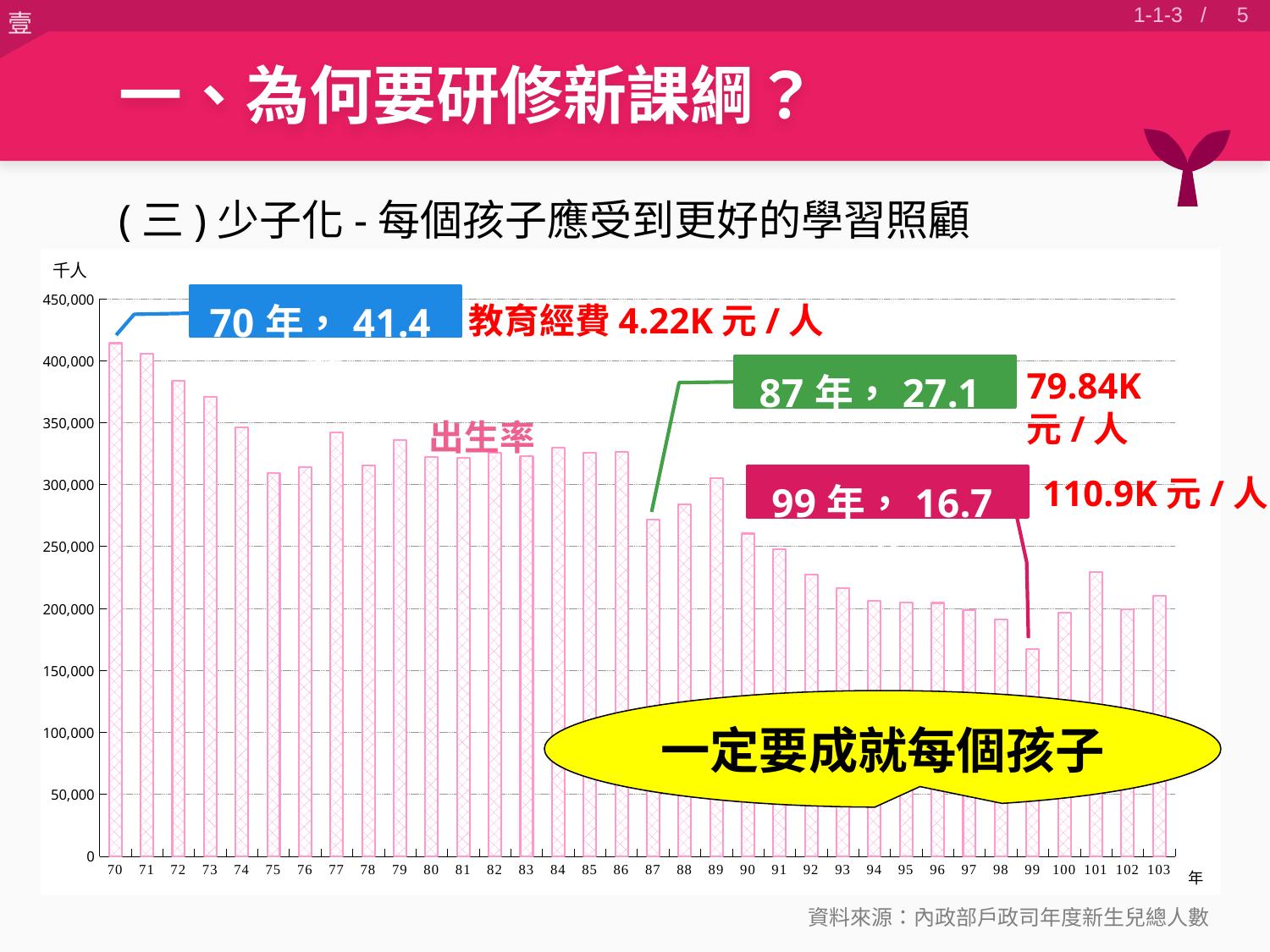
Is the value for year 72 greater or less than 350,000? greater Is the value for year 87 greater or less than 300,000? less Which year has the larger bar, year 101 or year 102? 101 Overall, do the bar values rise or fall from year 70 to year 103? fall What kind of chart is shown on the slide? bar chart Is the value for year 99 greater or less than 200,000? less What unit is shown at the top of the y axis? 千人 Which year has the highest bar in the chart? 70 How many years (categories) are plotted along the x axis of the chart? 34 Which year has the lowest bar in the chart? 99 What value does the callout give for year 87? 27.1